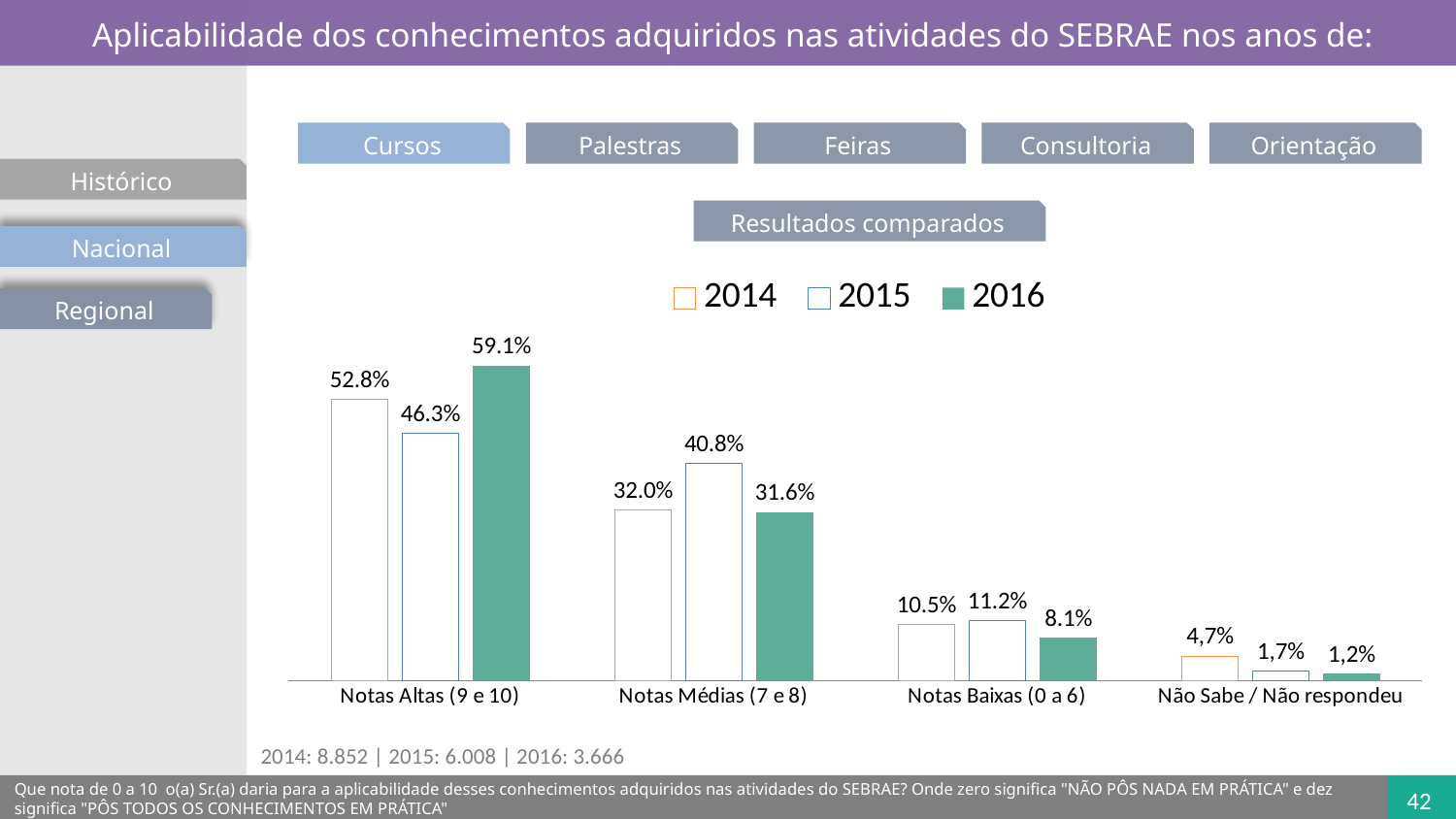
How many series does the legend list? 3 What is the difference between the 2016 and 2015 values in the Notas Altas (9 e 10) category? 12.8% What kind of chart is shown on the slide? Bar chart How many categories are shown on the x axis of the chart? 4 Which year has the lowest value in the Notas Baixas (0 a 6) category? 2016 What is the value for 2014 in the Notas Baixas (0 a 6) category? 10.5% Which year has the highest value in the Notas Altas (9 e 10) category? 2016 Which series is shown with solid green bars in the chart? 2016 What is the value for 2015 in the Notas Médias (7 e 8) category? 40.8% Which is larger in the Notas Médias (7 e 8) category: the 2014 value or the 2016 value? 2014 What is the value for 2016 in the Não Sabe / Não respondeu category? 1,2% What is the value for 2016 in the Notas Altas (9 e 10) category? 59.1%